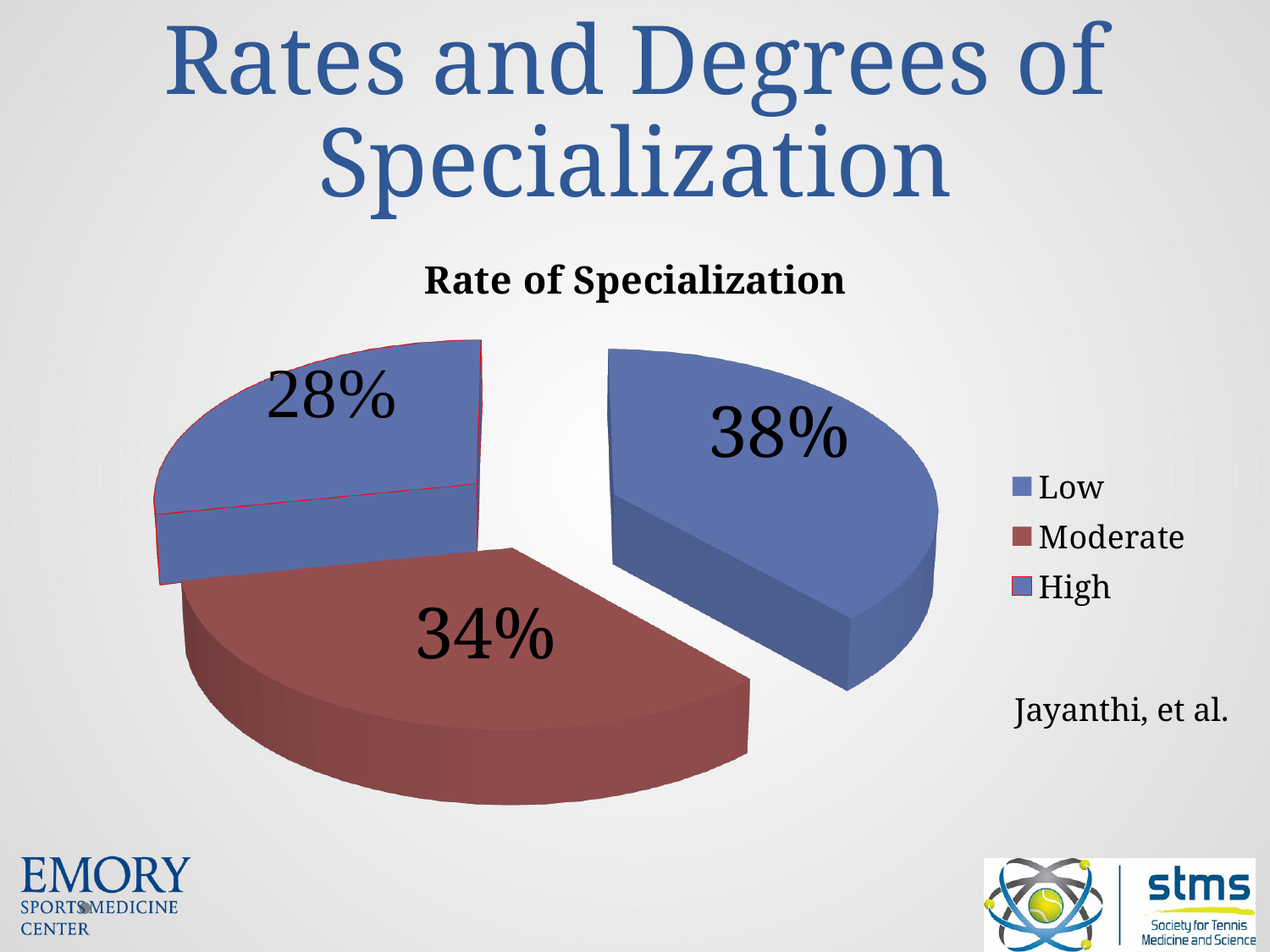
Is the Moderate slice greater or less than 30%? greater What is the percentage of the largest slice in the pie chart? 38% What colour is the Moderate slice? red What kind of chart is shown on the slide? pie chart What percentage is shown for the Moderate slice? 34% How many slices does the pie chart have? 3 What is the difference in percentage points between the largest slice (38%) and the smallest slice (28%)? 10 Which is larger, the Moderate slice or the slice labelled 28%? Moderate How many entries does the legend list? 3 What is the difference in percentage points between the largest slice (38%) and the Moderate slice? 4 What is the percentage of the smallest slice in the pie chart? 28% What is the title of the chart? Rate of Specialization